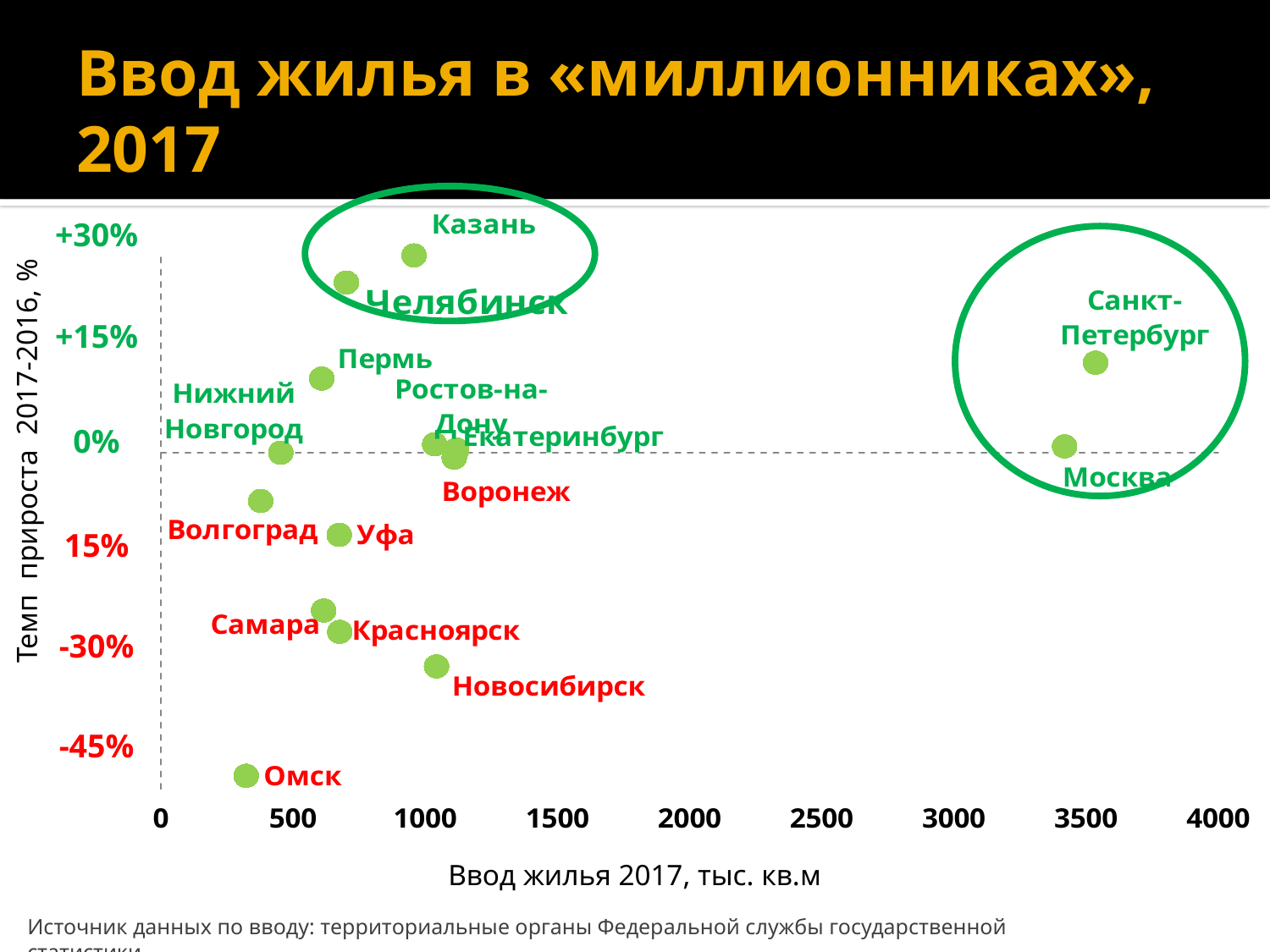
Is the growth rate for Пермь greater or less than 0%? greater Is the housing input (Ввод жилья 2017) for Омск greater or less than 500 тыс. кв.м? less Is the growth rate for Омск greater or less than -45%? less Which city has the larger housing input (Ввод жилья 2017): Москва or Омск? Москва What kind of chart is shown on the slide? scatter chart Which city has the lowest growth rate (Темп прироста) on the chart? Омск Which city has the highest growth rate (Темп прироста) on the chart? Казань What is the title of the horizontal axis of the chart? Ввод жилья 2017, тыс. кв.м Which city has the higher growth rate: Челябинск or Новосибирск? Челябинск